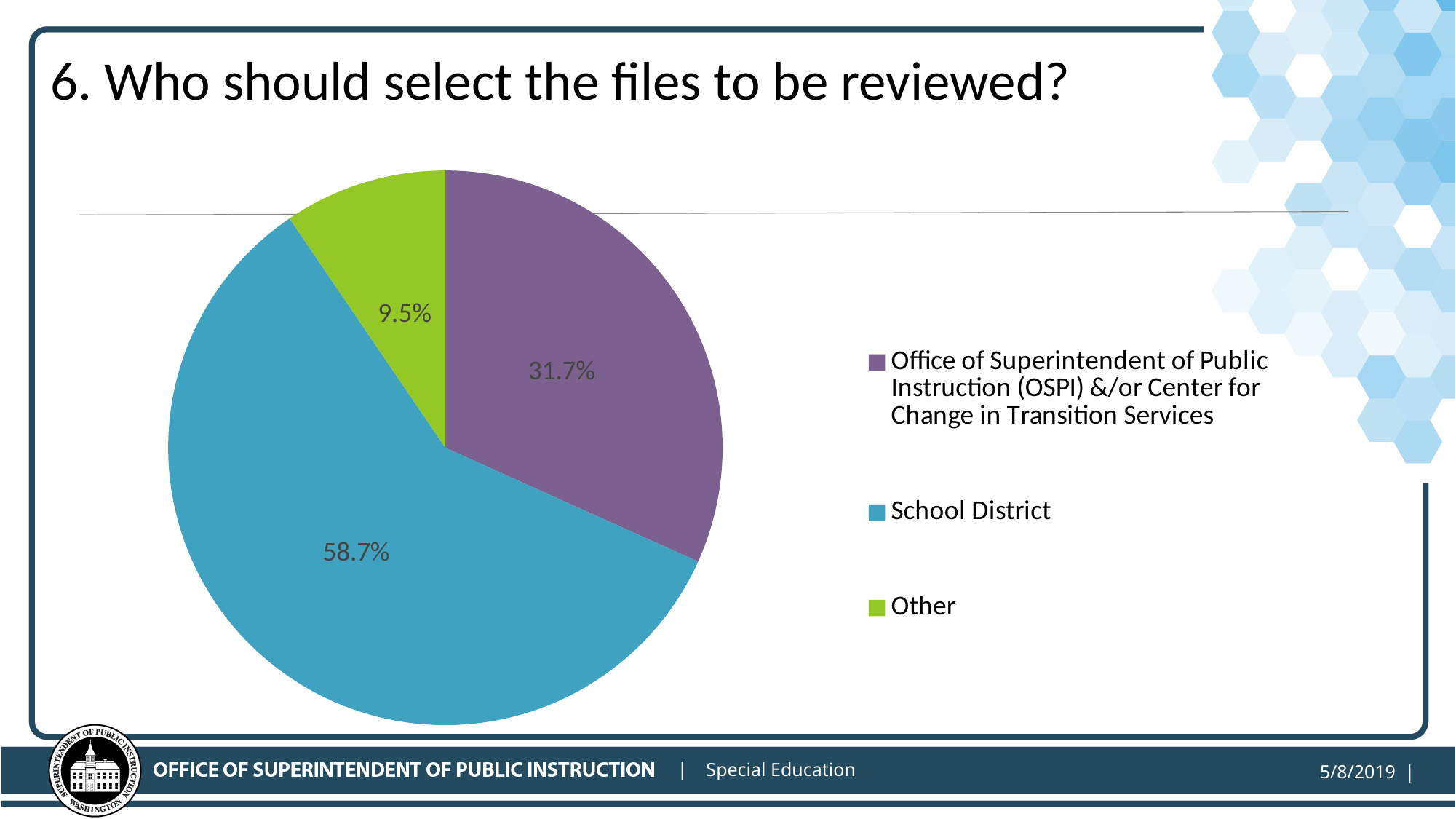
What is the difference in percentage points between School District and OSPI &/or Center for Change in Transition Services? 27 What is the title of the slide containing the chart? 6. Who should select the files to be reviewed? What colour is the slice for School District? Blue How many slices does the pie chart have? 3 What is the difference in percentage points between School District and Other? 49.2 What percentage of the pie is for Office of Superintendent of Public Instruction (OSPI) &/or Center for Change in Transition Services? 31.7% What percentage of the pie is for School District? 58.7% Which category has the smallest slice of the pie? Other What kind of chart is shown on the slide? Pie chart Which is larger, the slice for School District or the slice for OSPI &/or Center for Change in Transition Services? School District What percentage of the pie is for Other? 9.5% Which category has the largest slice of the pie? School District